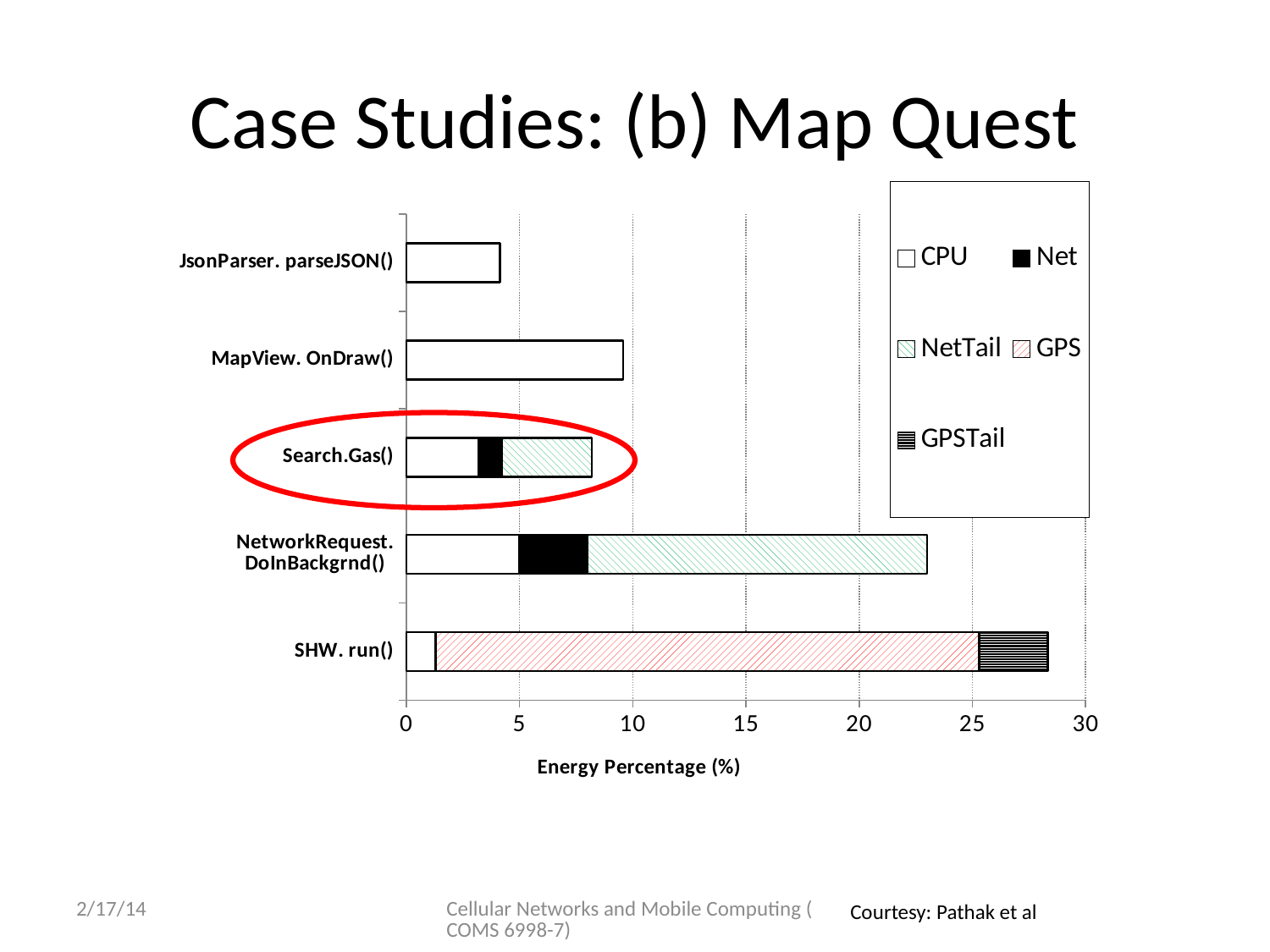
Which series accounts for most of the SHW. run() bar? GPS How many categories (methods) are plotted on the y axis? 5 What kind of chart is shown on the slide? Stacked horizontal bar chart Which method has the shortest total bar? JsonParser. parseJSON() Which has a larger total energy percentage, MapView. OnDraw() or Search.Gas()? MapView. OnDraw() Is the total energy percentage for JsonParser. parseJSON() greater or less than 5? less What is the label of the x axis? Energy Percentage (%) Which method has the longest total bar? SHW. run() Which has a larger total energy percentage, NetworkRequest. DoInBackgrnd() or SHW. run()? SHW. run() How many series does the legend list? 5 Is the total energy percentage for NetworkRequest. DoInBackgrnd() greater or less than 20? greater Is the total energy percentage for SHW. run() greater or less than 25? greater